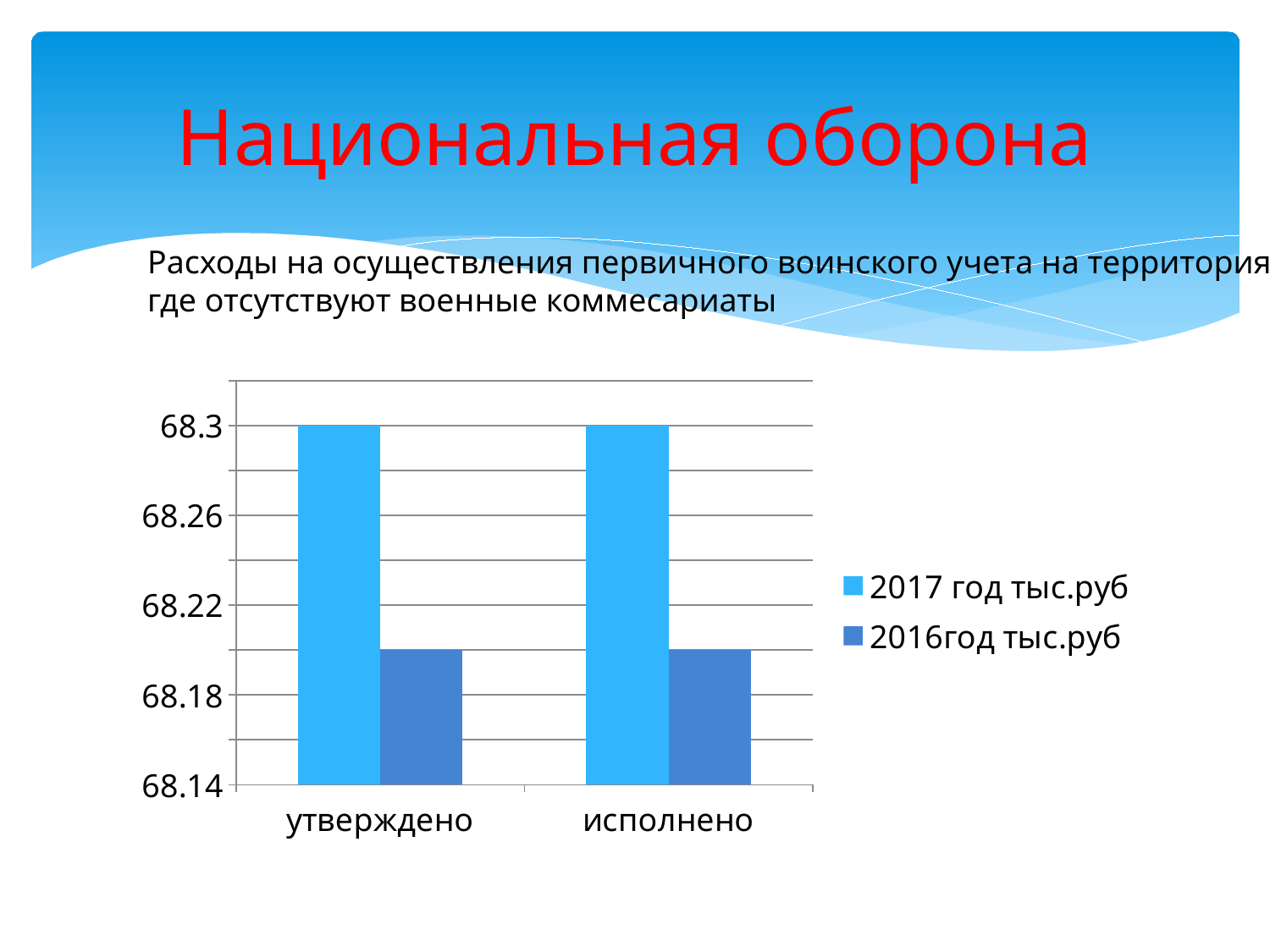
Is the value for 2016год тыс.руб in the утверждено category greater or less than 68.22? less What is the value for 2017 год тыс.руб in the исполнено category? 68.3 In the утверждено category, which series has the larger value, 2017 год тыс.руб or 2016год тыс.руб? 2017 год тыс.руб How many categories are shown on the x axis? 2 What are the two entries in the chart legend? 2017 год тыс.руб and 2016год тыс.руб What is the title of the slide? Национальная оборона Is the value for 2016год тыс.руб in the исполнено category greater or less than 68.18? greater Which series has the lowest bars in the chart? 2016год тыс.руб Do the values for 2017 год тыс.руб rise, fall or stay the same from утверждено to исполнено? stay the same What is the value for 2017 год тыс.руб in the утверждено category? 68.3 How many series does the legend list? 2 What kind of chart is shown on the slide? bar chart